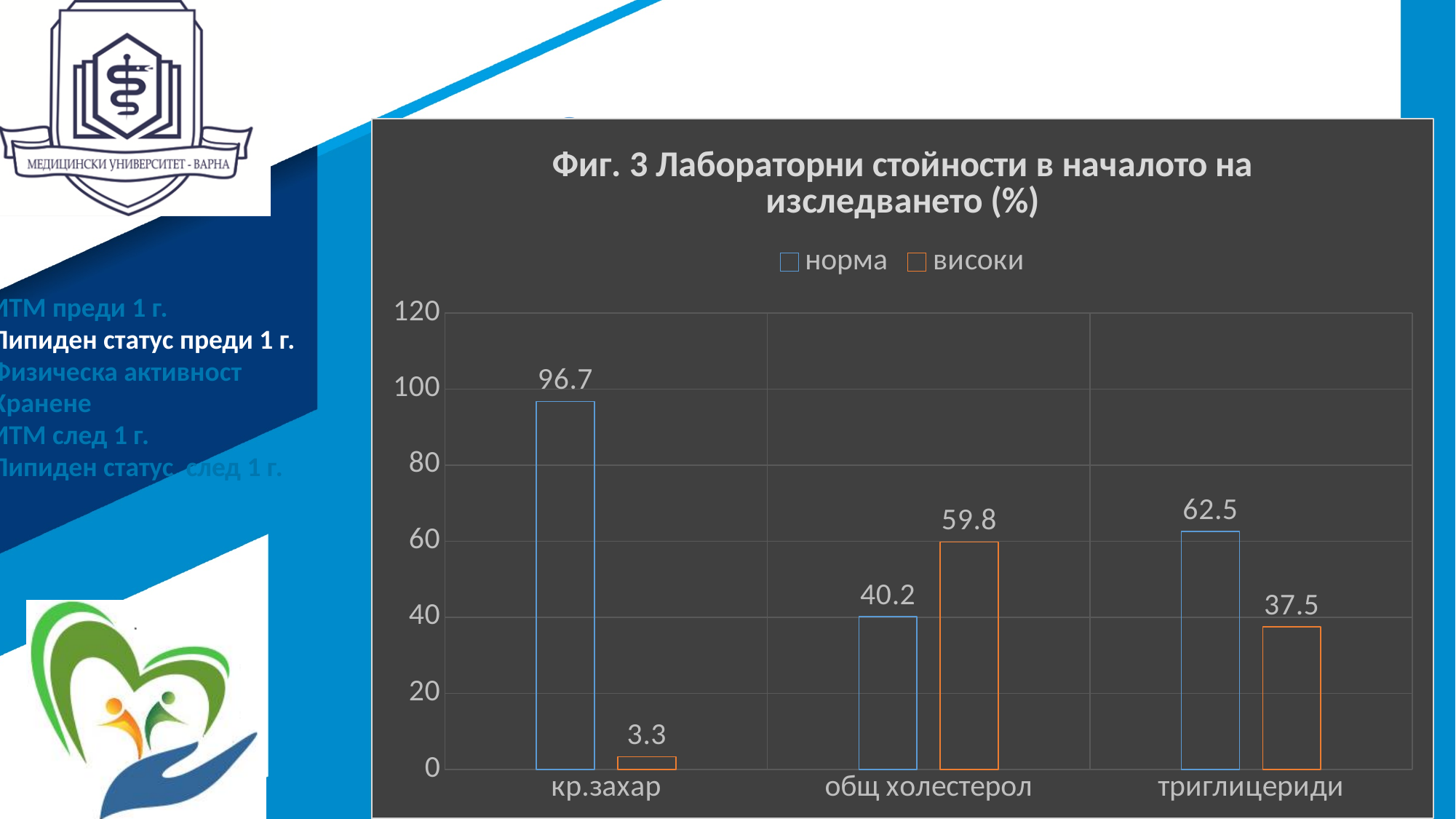
What is the value of the 'високи' series for 'триглицериди'? 37.5 What is the difference between the 'норма' and 'високи' values for 'триглицериди'? 25 What is the value of the 'високи' series for 'общ холестерол'? 59.8 What is the title of the chart? Фиг. 3 Лабораторни стойности в началото на изследването (%) Which category has the lowest 'високи' value? кр.захар How many categories are shown on the x axis? 3 How many series does the legend list? 2 What kind of chart is shown on the slide? bar chart Which category has the highest 'норма' value? кр.захар What is the value of the 'норма' series for 'кр.захар'? 96.7 What is the value of the 'норма' series for 'общ холестерол'? 40.2 For 'общ холестерол', which series has the larger value, 'норма' or 'високи'? високи